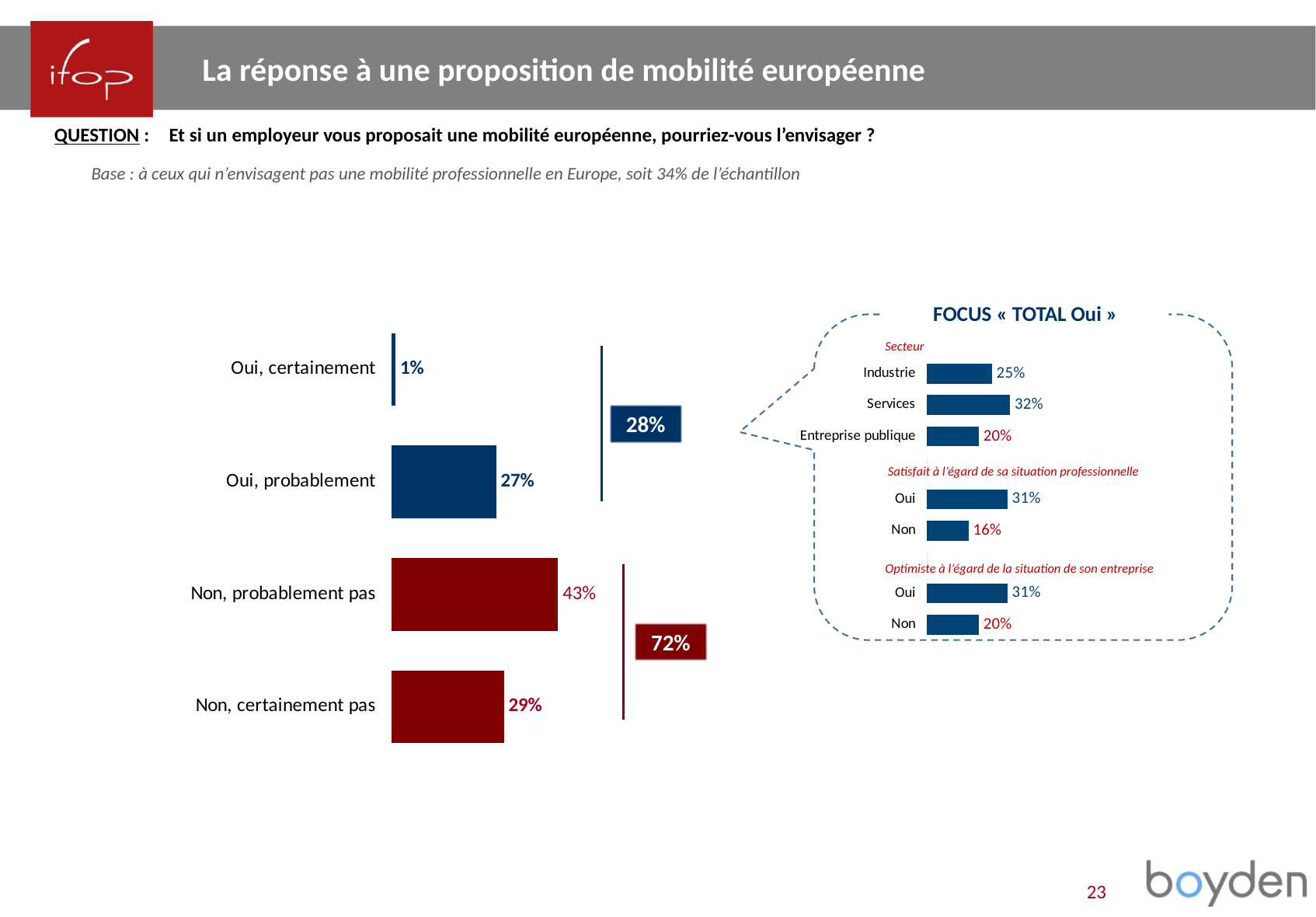
In the "FOCUS « TOTAL Oui »" chart, which Secteur category has the lowest value? Entreprise publique In the "FOCUS « TOTAL Oui »" chart, what is the value for Services? 32% What kind of chart is the main chart on the left? bar chart In the main bar chart on the left, what is the value for "Non, certainement pas"? 29% In the main bar chart on the left, which category has the highest value? Non, probablement pas In the main bar chart on the left, which category has the lowest value? Oui, certainement In the main bar chart on the left, what is the difference between "Non, probablement pas" and "Non, certainement pas"? 14% In the main bar chart on the left, how many categories are shown? 4 In the "FOCUS « TOTAL Oui »" chart, what is the difference between "Oui" and "Non" under "Satisfait à l'égard de sa situation professionnelle"? 15% In the "FOCUS « TOTAL Oui »" chart, which is larger: Industrie or Services? Services In the main bar chart on the left, what is the value for "Oui, probablement"? 27% In the main bar chart on the left, what is the total shown for the "Non" answers? 72%